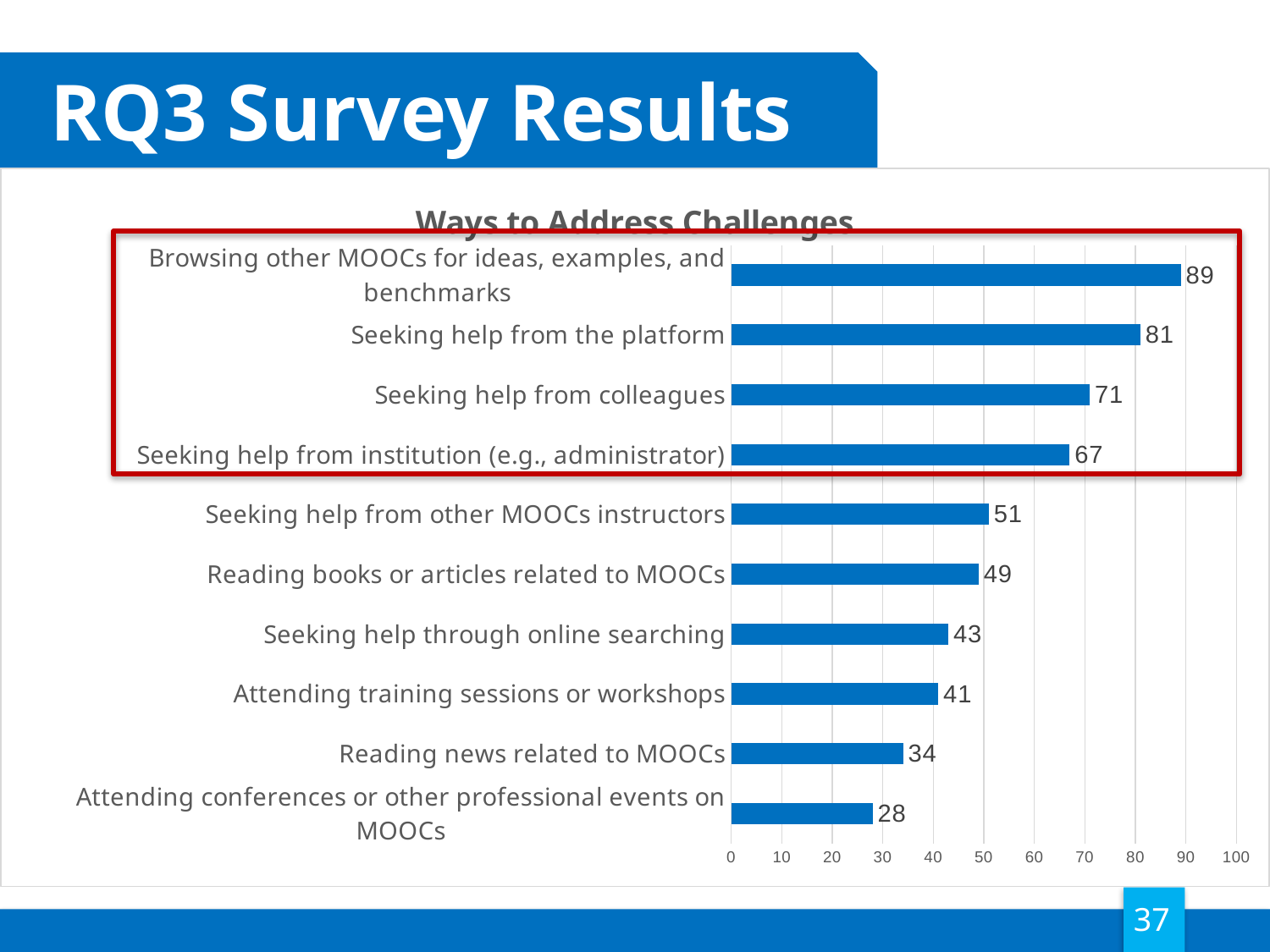
What kind of chart is shown on the slide? bar chart Which is larger: the value for "Seeking help from other MOOCs instructors" or "Reading books or articles related to MOOCs"? Seeking help from other MOOCs instructors What is the value for "Reading news related to MOOCs"? 34 What is the value for "Seeking help from the platform"? 81 What is the difference between the values for "Seeking help from colleagues" and "Seeking help from institution (e.g., administrator)"? 4 What is the value for "Seeking help through online searching"? 43 Is the value for "Attending training sessions or workshops" greater or less than 50? less What is the difference between the highest and lowest values in the chart? 61 How many categories are shown in the chart? 10 What is the title of the chart? Ways to Address Challenges Which category has the lowest value? Attending conferences or other professional events on MOOCs Which category has the highest value? Browsing other MOOCs for ideas, examples, and benchmarks